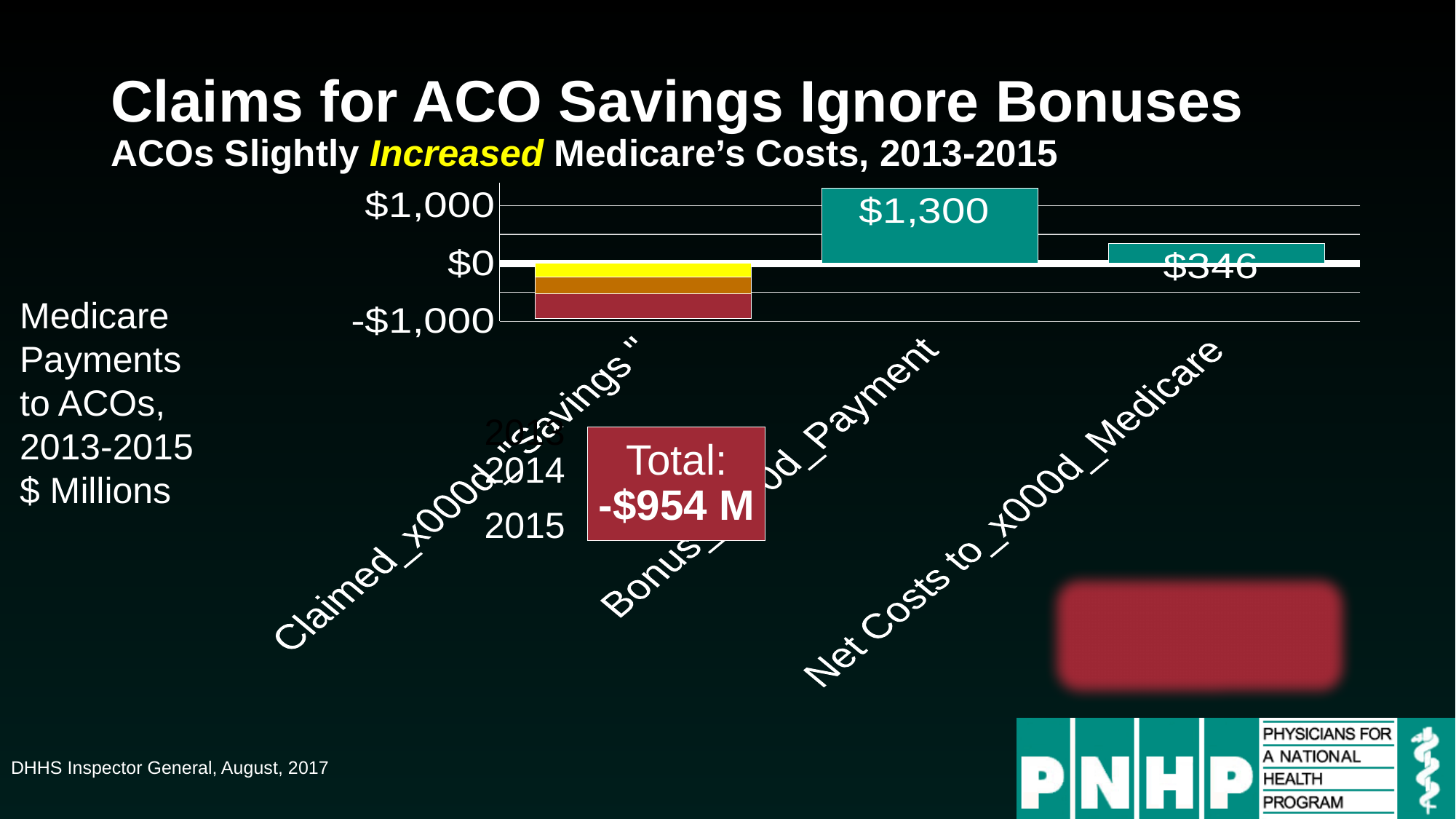
What total is printed for the Claimed "Savings" bar? -$954 M What is the value of the Bonus Payment bar? $1,300 Which category has the highest value? Bonus Payment What is the difference between the Bonus Payment value and the Net Costs to Medicare value? $954 Which is larger, the Bonus Payment bar or the Net Costs to Medicare bar? Bonus Payment How many categories are shown on the x axis? 3 Is the value for Bonus Payment greater or less than $1,000? greater What kind of chart is shown on the slide? Bar chart Which category has the lowest value? Claimed "Savings" What is the value of the Net Costs to Medicare bar? $346 Is the value for Net Costs to Medicare greater or less than $1,000? less